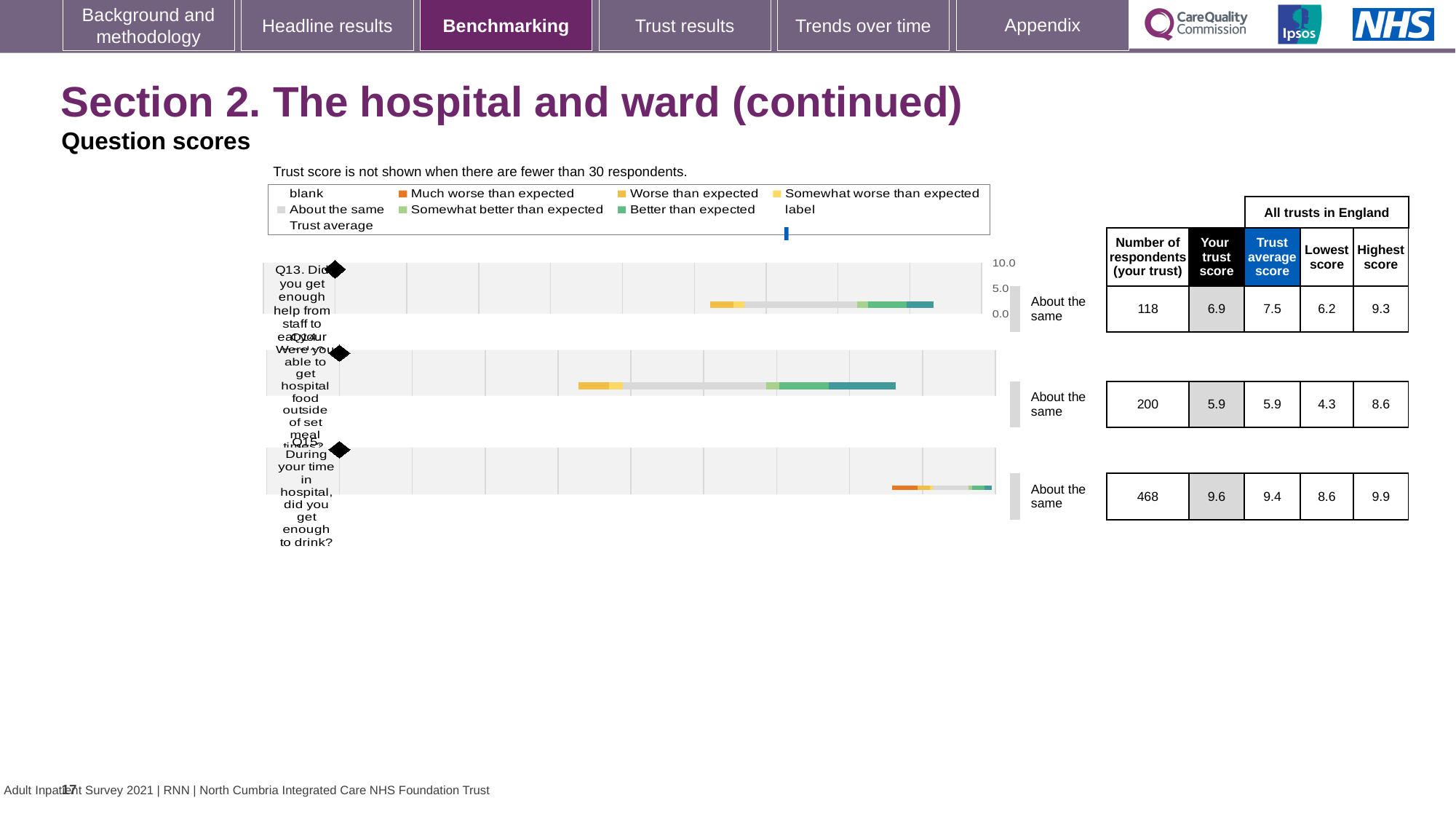
What is the number of respondents for Q13 (Did you get enough help from staff to eat your meals?)? 118 What is the highest score across all trusts in England for Q13? 9.3 What is the difference between the highest score and the lowest score for Q15? 1.3 What colour does the legend use for 'Much worse than expected'? Orange Which question has the lowest 'Your trust score'? Q14 What is your trust score for Q14 (Were you able to get hospital food outside of set meal times?)? 5.9 Which question has the highest 'Your trust score'? Q15 What benchmark category label is shown next to the bar for Q14? About the same How many questions (categories) are plotted in the chart? 3 What kind of chart is used to show the question scores on this slide? bar chart What is the trust average score for Q15 (did you get enough to drink?)? 9.4 For Q13, which is larger: your trust score or the trust average score? Trust average score